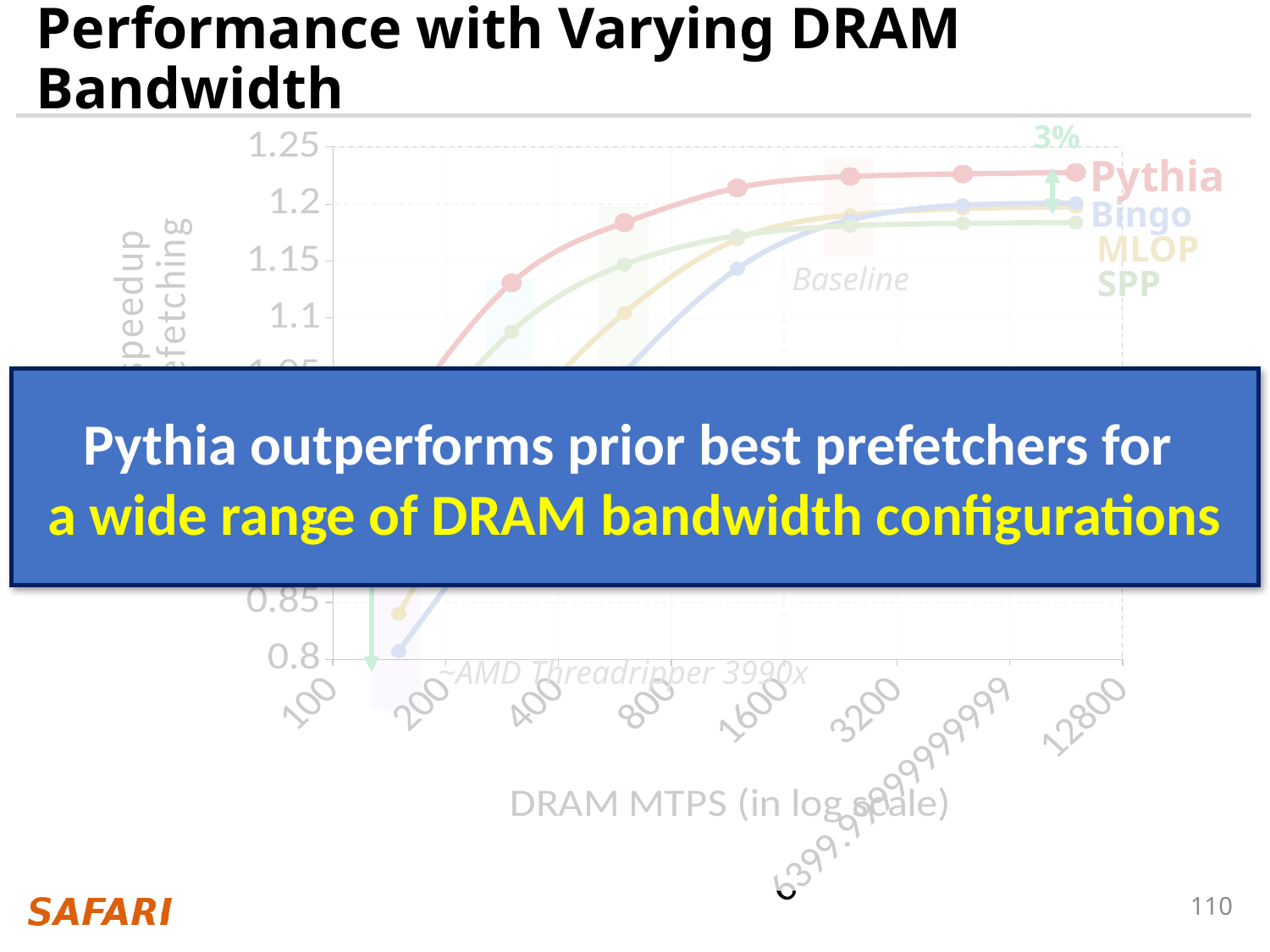
What percentage annotation is shown above the rightmost points of the chart? 3% What kind of chart is shown on the slide? line chart Does the Pythia series rise or fall as DRAM MTPS increases along the x axis? rise Which series has the lowest speedup at the rightmost point (12800 DRAM MTPS)? SPP How many series does the chart's legend list? 4 Which series has the highest speedup at the rightmost point (12800 DRAM MTPS)? Pythia What is the label of the x axis of the chart? DRAM MTPS (in log scale)